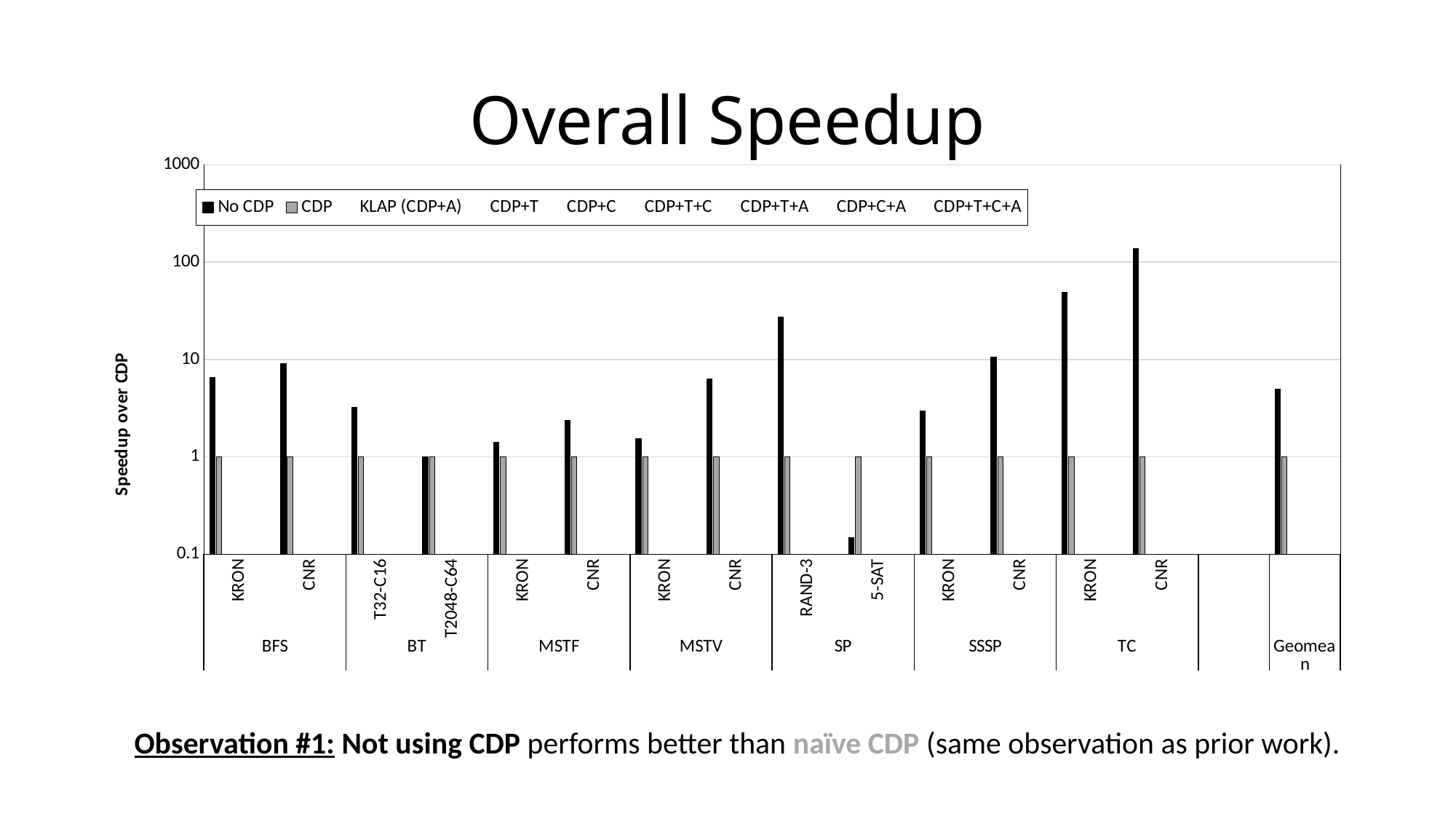
What is the CDP value for Geomean? 1 Which is larger, the No CDP value for KRON under TC or the No CDP value for KRON under BFS? KRON under TC Is the No CDP value for 5-SAT under SP greater or less than 1? less What is the title of the chart? Overall Speedup What is the label of the vertical axis? Speedup over CDP Which benchmark input has the lowest No CDP bar? 5-SAT under SP Which benchmark input has the highest No CDP bar? CNR under TC What kind of chart is shown on the slide? bar chart Is the No CDP value for CNR under TC greater or less than 100? greater Is the No CDP value for RAND-3 under SP greater or less than 10? greater How many series does the legend list? 9 What is the CDP value for KRON under BFS? 1